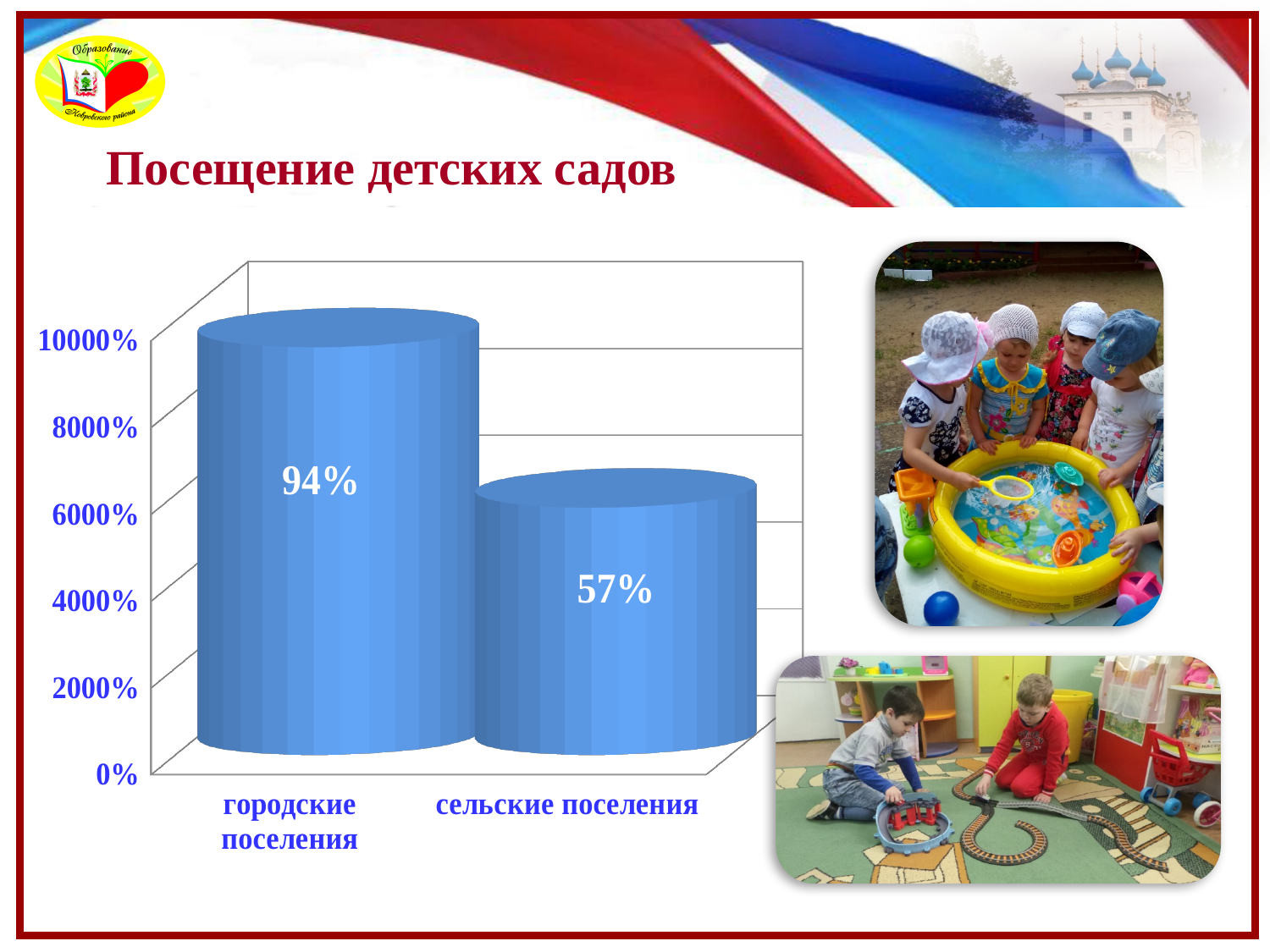
What is the value shown for сельские поселения? 57% Which category has the highest value? городские поселения What colour are the bars in the chart? blue What is the value shown for городские поселения? 94% What is the difference between the values for городские поселения and сельские поселения? 37% Do the values rise or fall from left to right along the x axis? fall How many categories are shown on the chart? 2 Which category has the lowest value? сельские поселения Which is larger, the value for городские поселения or for сельские поселения? городские поселения What is the title of the slide containing the chart? Посещение детских садов What kind of chart is shown on the slide? bar chart What is the highest tick label shown on the vertical axis? 10000%